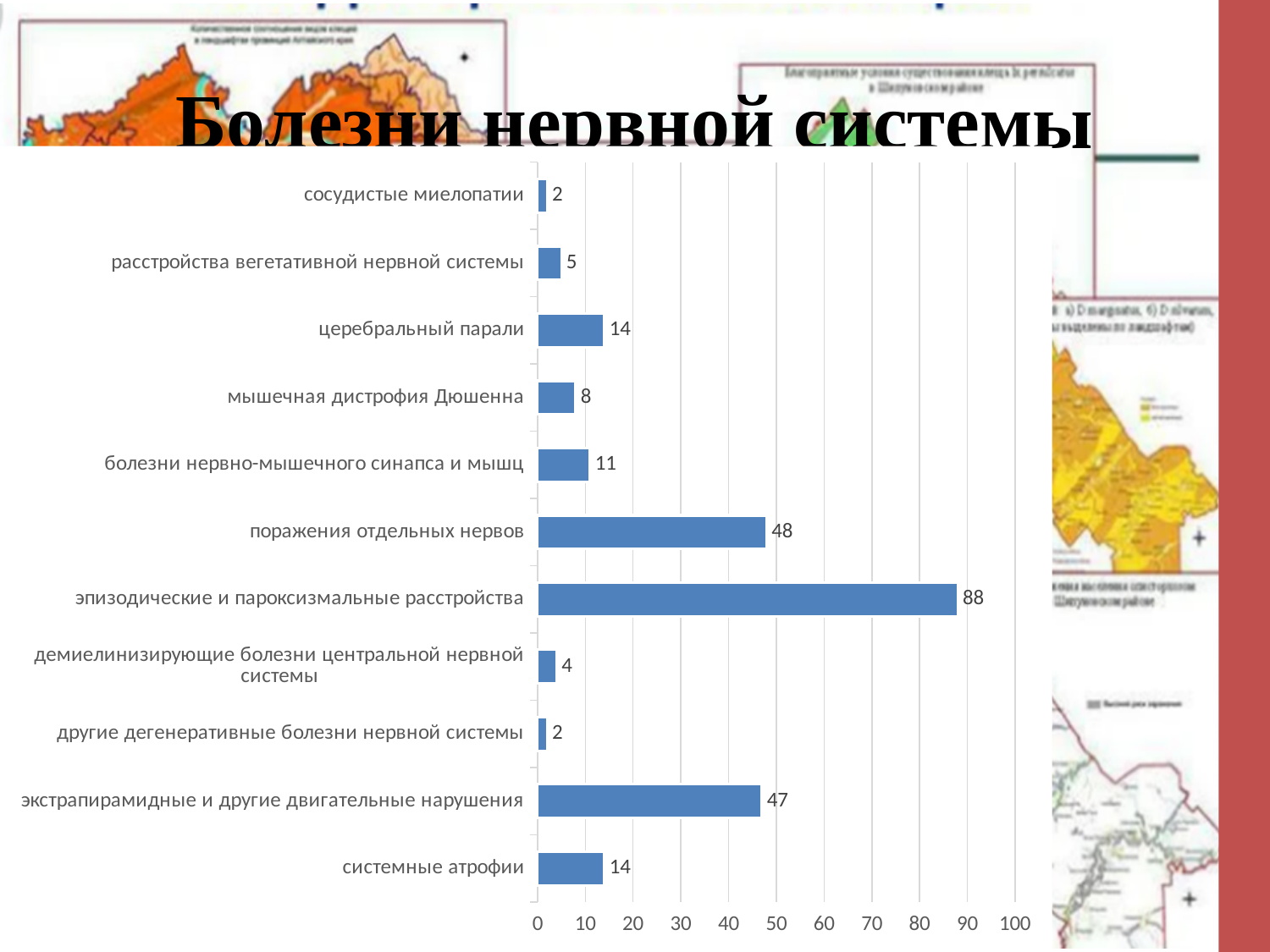
Which is larger: the value for поражения отдельных нервов or the value for экстрапирамидные и другие двигательные нарушения? поражения отдельных нервов What is the value for эпизодические и пароксизмальные расстройства? 88 How many categories are shown in the chart? 11 What is the title of the slide? Болезни нервной системы What is the difference between the values for эпизодические и пароксизмальные расстройства and поражения отдельных нервов? 40 What is the difference between the values for экстрапирамидные и другие двигательные нарушения and системные атрофии? 33 What is the value for поражения отдельных нервов? 48 What is the value for церебральный парали? 14 Is the value for мышечная дистрофия Дюшенна greater or less than 10? less Which category has the highest value? эпизодические и пароксизмальные расстройства What is the value for болезни нервно-мышечного синапса и мышц? 11 What kind of chart is shown on the slide? bar chart